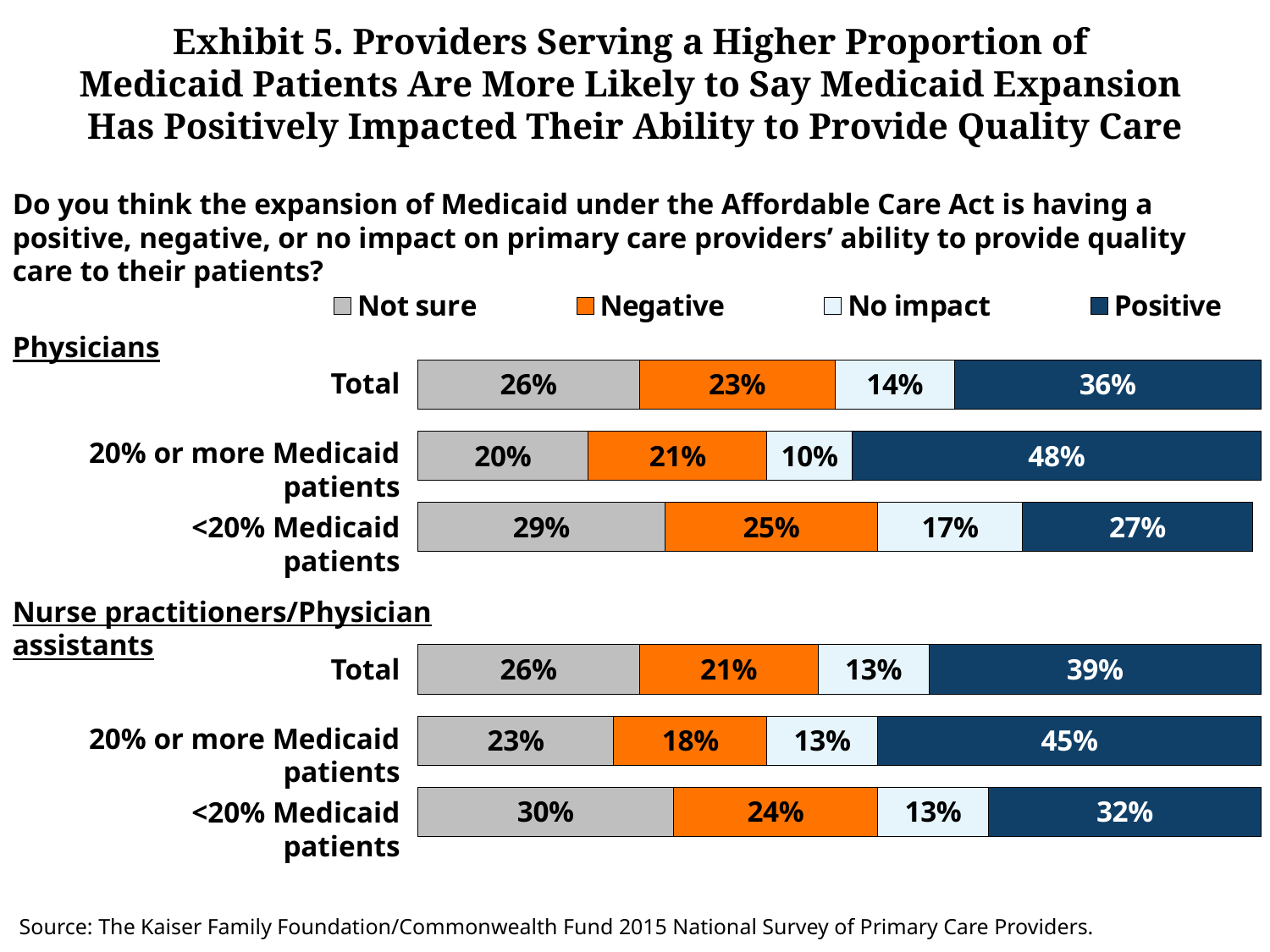
What kind of chart is shown on the slide? Stacked bar chart How many series does the legend list? 4 How many bars are shown on the slide? 6 What percentage of all physicians (Total) said Medicaid expansion had a negative impact? 23% What percentage of physicians with 20% or more Medicaid patients said Medicaid expansion had a positive impact? 48% What percentage of nurse practitioners/physician assistants with 20% or more Medicaid patients said there was no impact? 13% Which is larger: the Negative share for physicians with <20% Medicaid patients or for nurse practitioners/physician assistants with <20% Medicaid patients? Physicians, <20% Medicaid patients Which colour represents the Negative response in the legend? Orange Which group has the lowest Positive share across all bars? Physicians, <20% Medicaid patients What percentage of nurse practitioners/physician assistants with <20% Medicaid patients said they were not sure? 30% What is the difference in the Positive share between physicians with 20% or more Medicaid patients and physicians with <20% Medicaid patients? 21 percentage points Which group has the highest Positive share across all bars? Physicians, 20% or more Medicaid patients